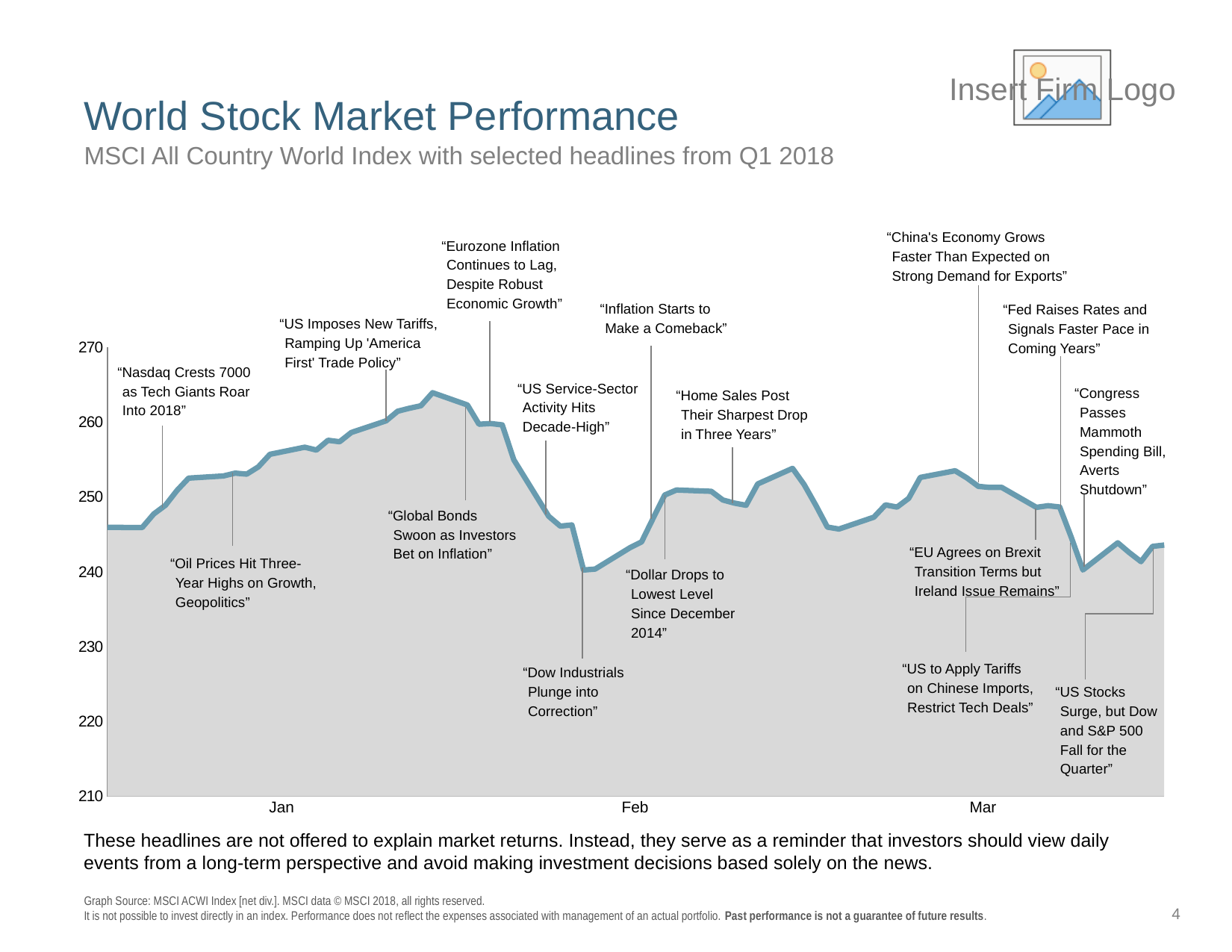
Is the index value at the start of January greater or less than 250? less In which month does the index reach its highest level in the chart? Jan Does the index rise or fall from its late-January peak to early February? fall Is the data in the chart plotted as bars or as a line? a line What is the title of the chart on the slide? World Stock Market Performance Is the index value at the end of March greater or less than 250? less Does the index rise or fall from the start of January to its late-January peak? rise Which index does the chart track, according to the subtitle? MSCI All Country World Index What is the highest value shown on the y axis of the chart? 270 Is the index's peak value in late January greater or less than 260? greater How many months are labelled on the x axis of the chart? 3